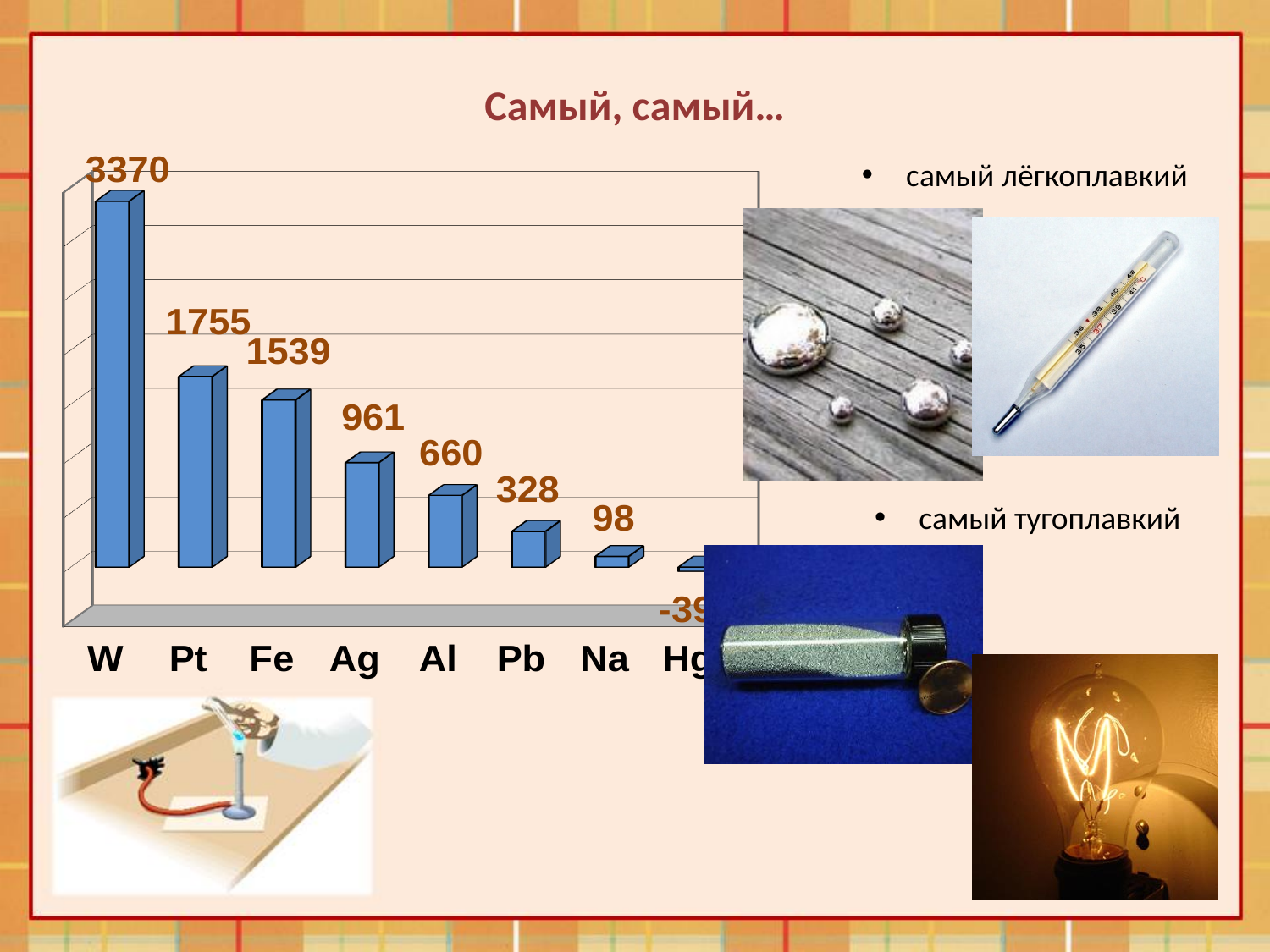
What is the value shown for Na? 98 What is the value shown for Pt? 1755 What is the difference between the values for Al and Pb? 332 What is the value shown for Ag? 961 What is the value shown for W? 3370 What is the value shown for Fe? 1539 Which is larger, the value for Ag or the value for Al? Ag Which category has the highest value? W Do the values rise or fall from left to right along the x axis? fall How many categories are shown on the chart? 8 Which category has the lowest value? Hg What is the difference between the values for W and Pt? 1615